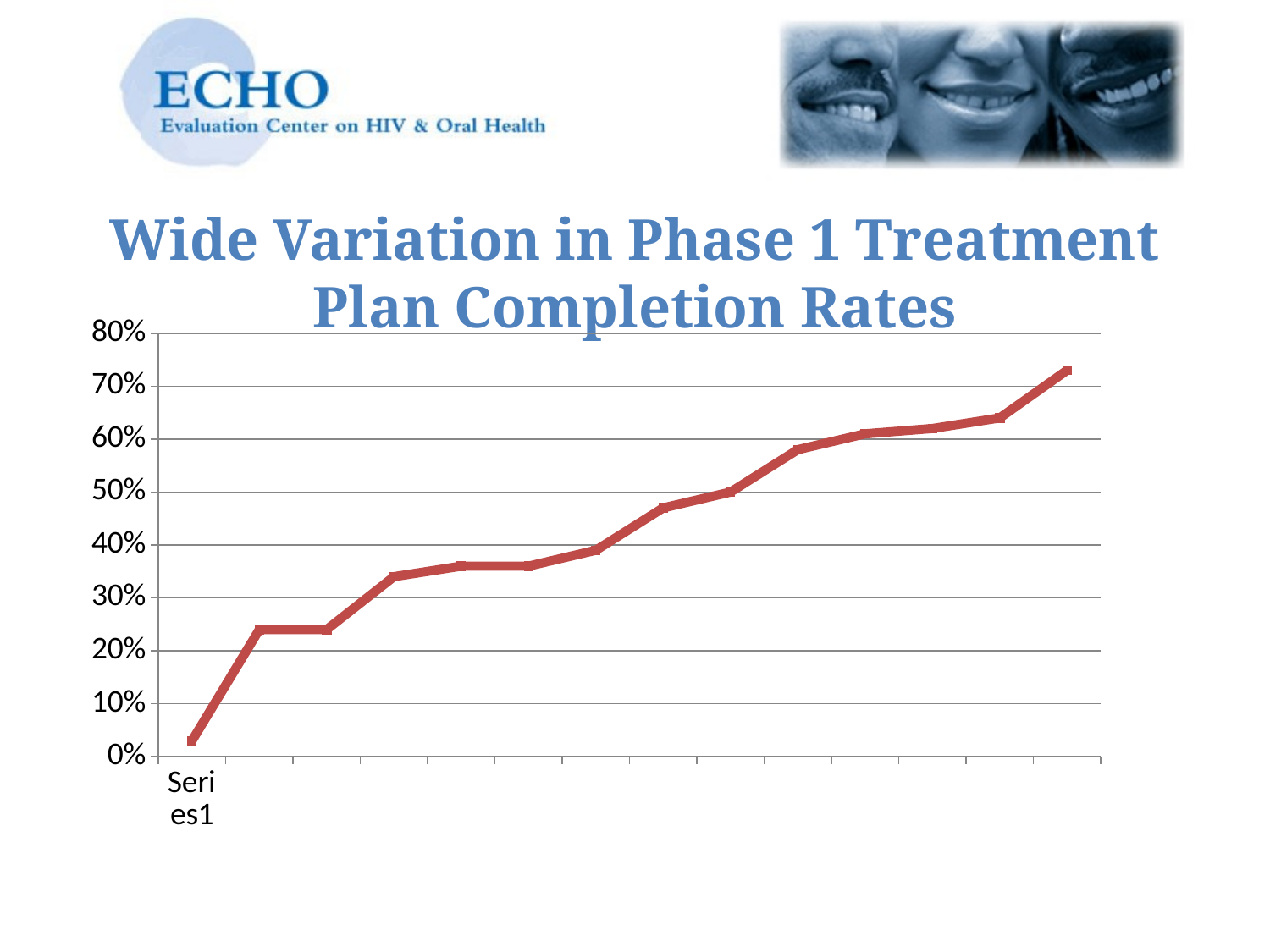
What is the highest value shown on the y axis? 80% Is the value of the second point from the left greater or less than 20%? greater Which point has the highest value, the first or the last? the last Is the value of the last (rightmost) point greater or less than 70%? greater Is the value of the first (leftmost) point greater or less than 10%? less Which point has the lowest value, the first or the last? the first What is the title of the chart on the slide? Wide Variation in Phase 1 Treatment Plan Completion Rates Do the values rise or fall from left to right along the x axis? rise How many data points are plotted on the line? 14 Is the value of the first point larger or smaller than the value of the last point? smaller What kind of chart is shown on the slide? line chart